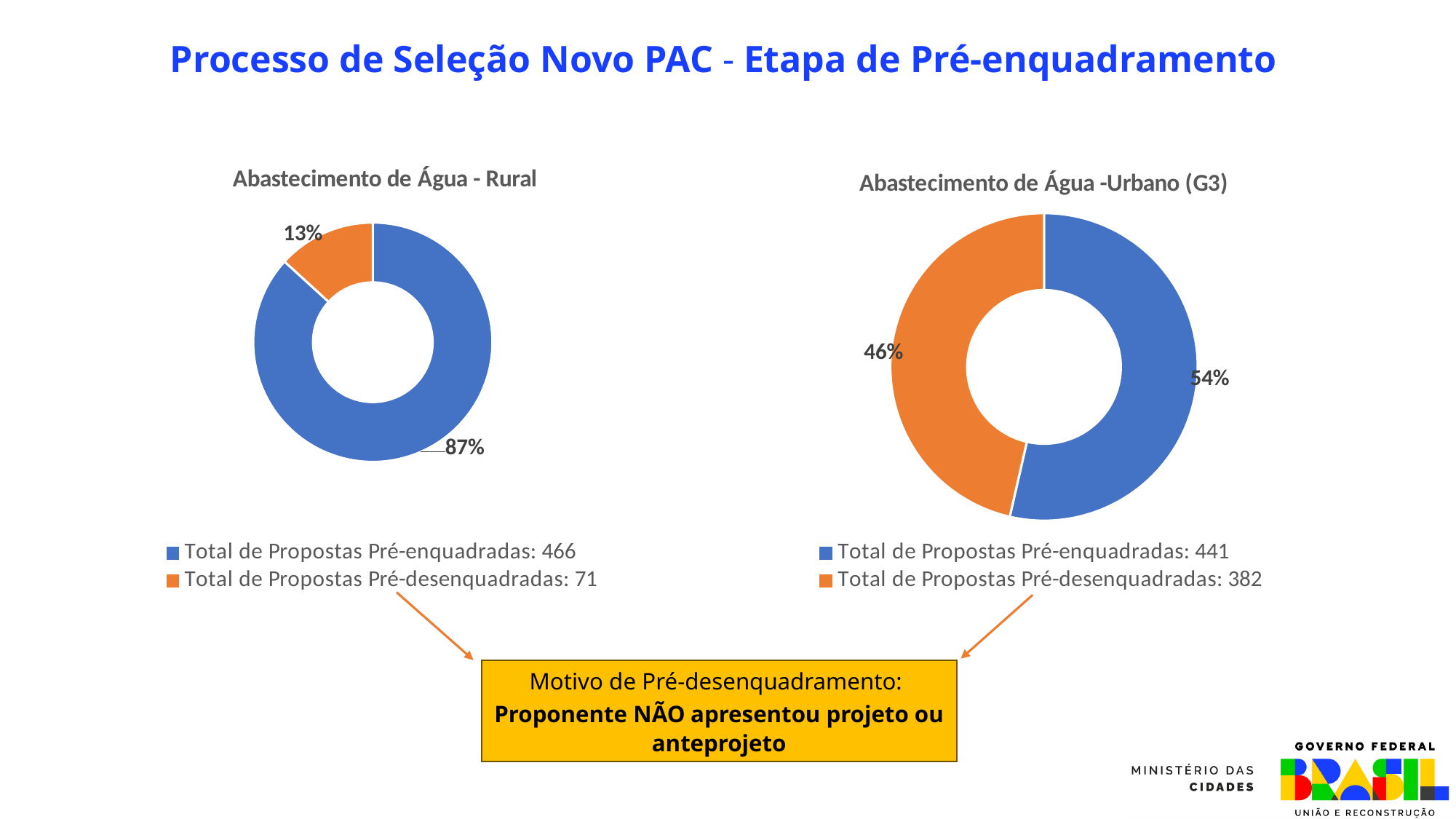
What type of chart is used for 'Abastecimento de Água -Urbano (G3)'? Doughnut (pie) chart In the 'Abastecimento de Água -Urbano (G3)' chart, what share of proposals is Pré-desenquadradas? 46% In the 'Abastecimento de Água -Urbano (G3)' chart, what colour is the Pré-desenquadradas slice? Orange In the 'Abastecimento de Água -Urbano (G3)' chart, what is the total number of Propostas Pré-desenquadradas shown in the legend? 382 How many series does the legend of the 'Abastecimento de Água - Rural' chart list? 2 In the 'Abastecimento de Água - Rural' chart, what is the difference in percentage points between the Pré-enquadradas and Pré-desenquadradas slices? 74 In the 'Abastecimento de Água - Rural' chart, what is the total number of Propostas Pré-desenquadradas shown in the legend? 71 In the 'Abastecimento de Água -Urbano (G3)' chart, which slice is larger, Pré-enquadradas or Pré-desenquadradas? Pré-enquadradas In the 'Abastecimento de Água -Urbano (G3)' chart, what share of proposals is Pré-enquadradas? 54% In the 'Abastecimento de Água - Rural' chart, what share of proposals is Pré-desenquadradas? 13% In the 'Abastecimento de Água - Rural' chart, what is the total number of Propostas Pré-enquadradas shown in the legend? 466